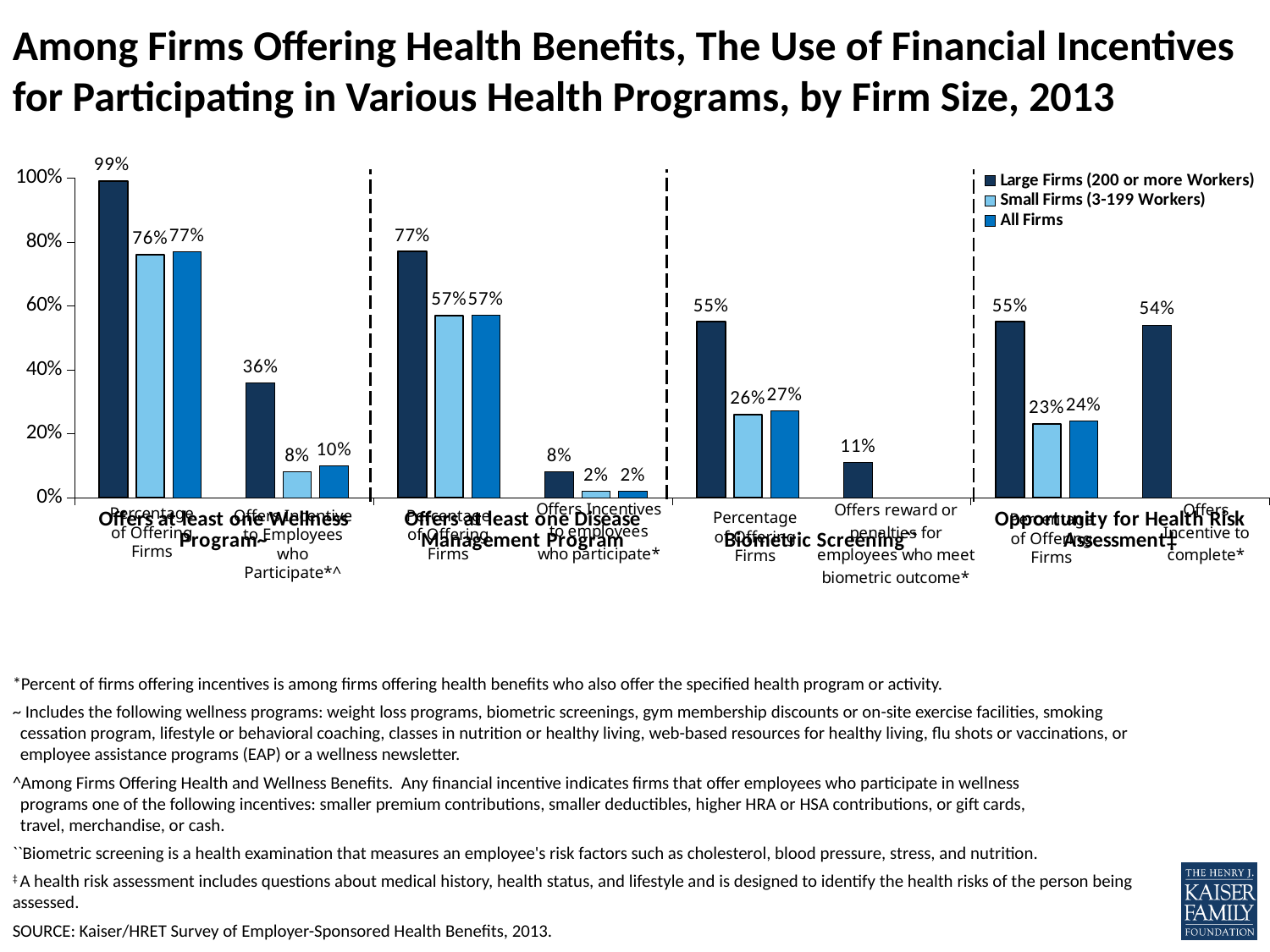
What percentage of large firms (200 or more workers) offer at least one wellness program? 99% What percentage of large firms offer a reward or penalties for employees who meet a biometric outcome? 11% Which series has the highest value for the percentage of firms offering at least one wellness program? Large Firms (200 or more Workers) What percentage of all firms offer biometric screening? 27% What kind of chart is shown on the slide? Bar chart What is the source cited for the chart? Kaiser/HRET Survey of Employer-Sponsored Health Benefits, 2013 Which is larger: the percentage of large firms offering at least one wellness program or the percentage of large firms offering at least one disease management program? Offers at least one wellness program What percentage of small firms (3-199 workers) offer at least one disease management program? 57% What is the difference between the percentage of large firms and small firms offering an incentive to employees who participate in a wellness program? 28% How many series does the legend list? 3 What percentage of large firms offer an incentive to complete a health risk assessment? 54% What is the lowest value shown for offering incentives to employees who participate in a disease management program? 2%